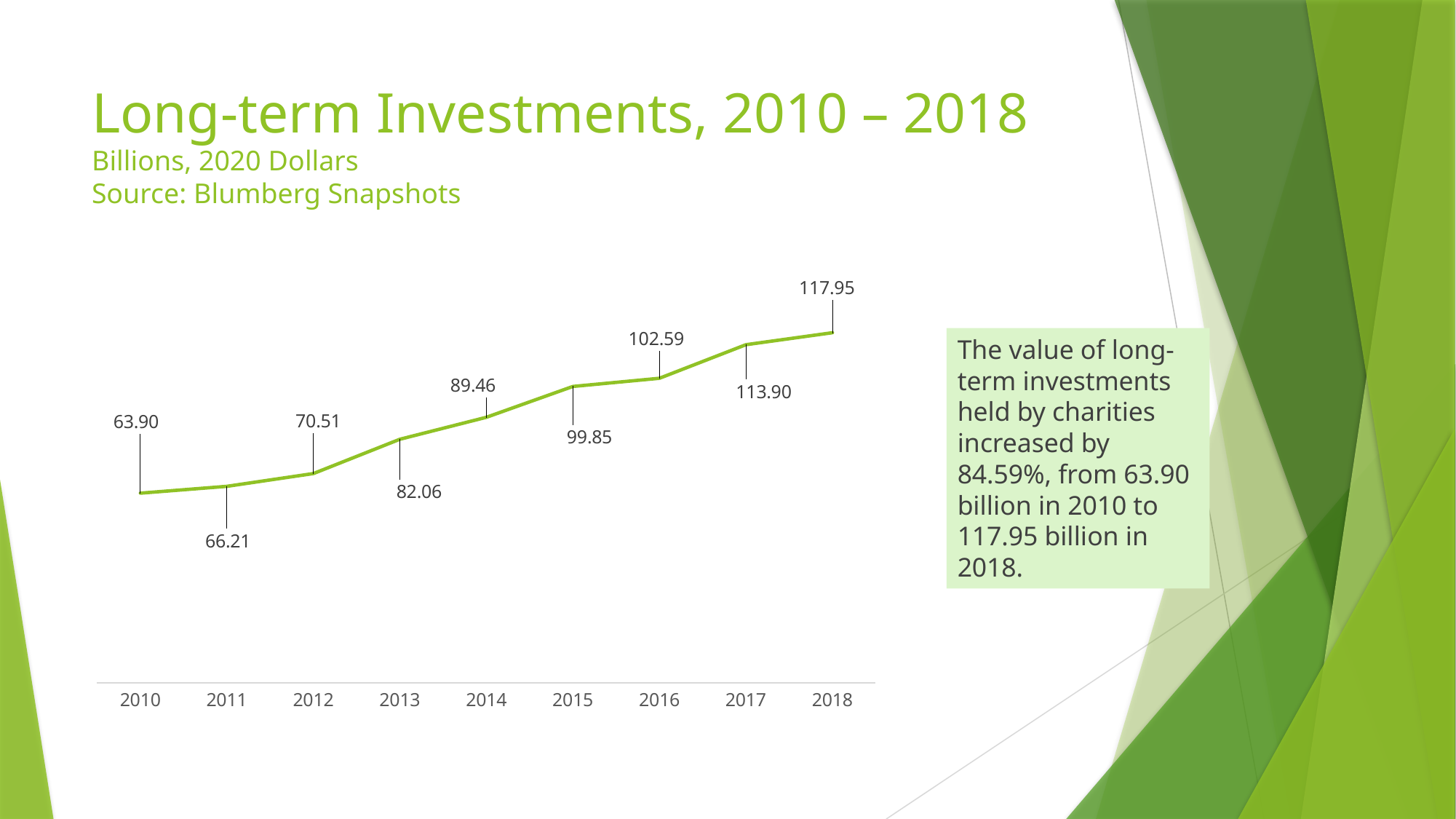
Do the values rise or fall from 2010 to 2018? rise Which year has the lowest value? 2010 How many years are plotted on the chart? 9 What is the value for 2018? 117.95 What is the value for 2010? 63.90 What is the value for 2013? 82.06 Which year has the highest value? 2018 What is the difference between the values for 2018 and 2010? 54.05 Which is larger, the value for 2012 or the value for 2013? 2013 What kind of chart is shown on the slide? line chart What is the difference between the values for 2015 and 2014? 10.39 What is the value for 2016? 102.59